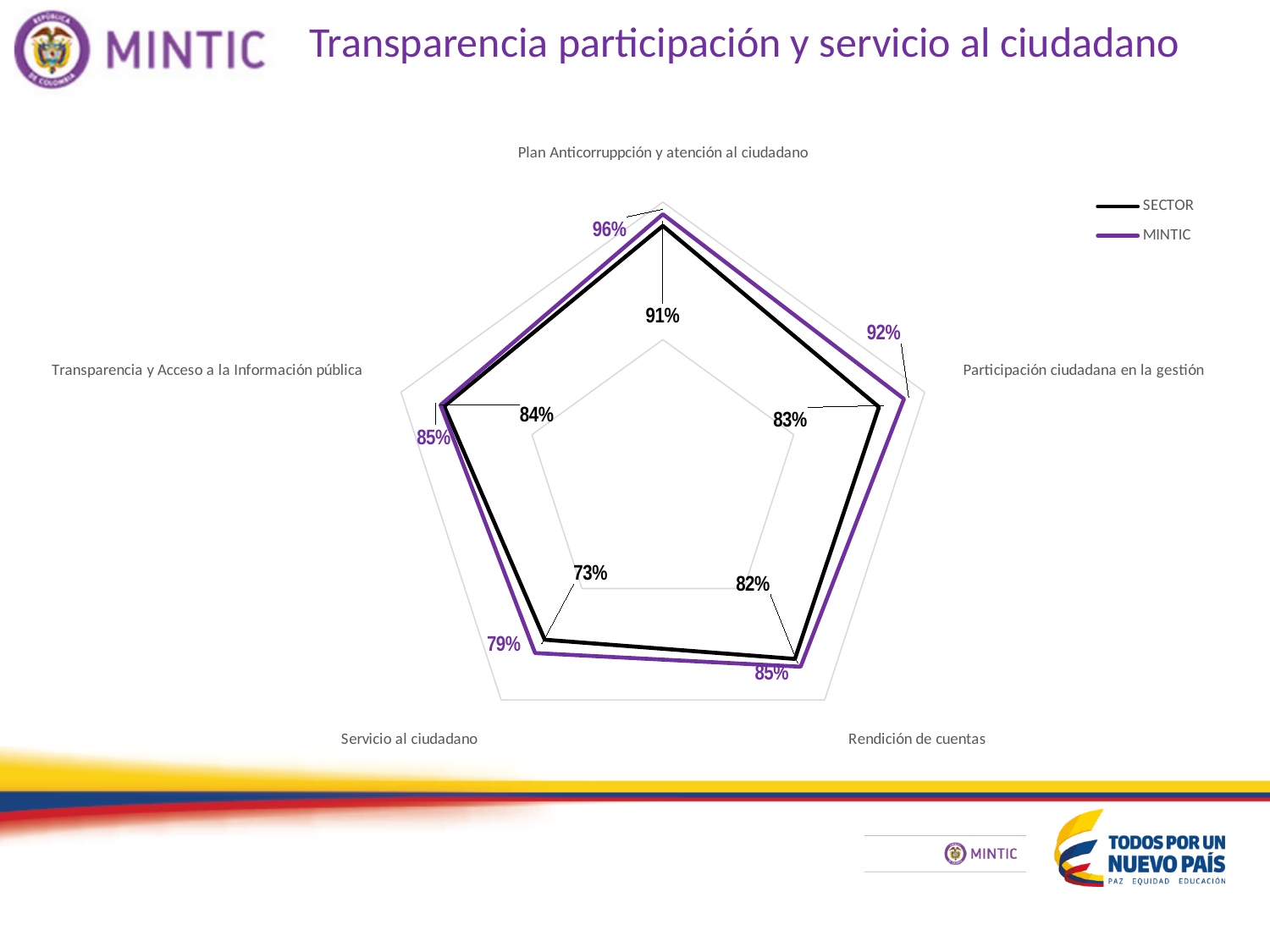
What is the SECTOR value for Plan Anticorruppción y atención al ciudadano? 91% What is the MINTIC value for Participación ciudadana en la gestión? 92% What kind of chart is shown on the slide? Radar chart What is the MINTIC value for Plan Anticorruppción y atención al ciudadano? 96% Which colour represents the MINTIC series in the legend? Purple How many categories does the radar chart have? 5 How many series does the legend list? 2 What is the difference between the MINTIC and SECTOR values for Participación ciudadana en la gestión? 9% Which is larger for Servicio al ciudadano, the MINTIC value or the SECTOR value? MINTIC Which category has the highest MINTIC value? Plan Anticorruppción y atención al ciudadano What is the SECTOR value for Servicio al ciudadano? 73% Which category has the lowest SECTOR value? Servicio al ciudadano